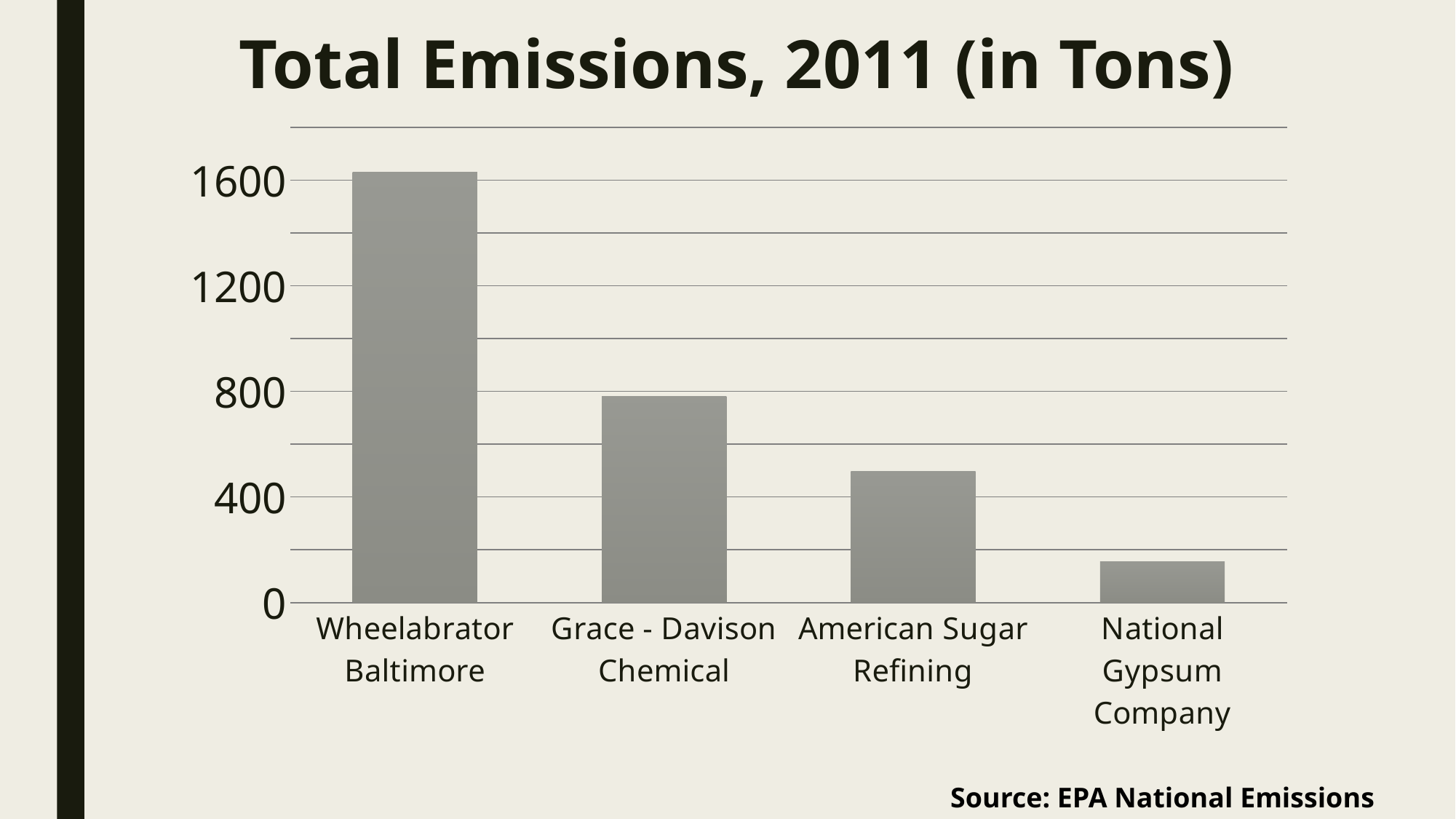
Which company has the highest total emissions in the chart? Wheelabrator Baltimore Which has higher total emissions, Grace - Davison Chemical or American Sugar Refining? Grace - Davison Chemical What is the title of the chart? Total Emissions, 2011 (in Tons) Which company has the lowest total emissions in the chart? National Gypsum Company Is the value for Grace - Davison Chemical greater or less than 400? greater How many companies are shown on the x axis of the chart? 4 What kind of chart is shown on the slide? bar chart Is the value for American Sugar Refining greater or less than 800? less Is the value for National Gypsum Company greater or less than 400? less Which has higher total emissions, Wheelabrator Baltimore or National Gypsum Company? Wheelabrator Baltimore Do the bar values rise or fall moving from left to right across the chart? fall